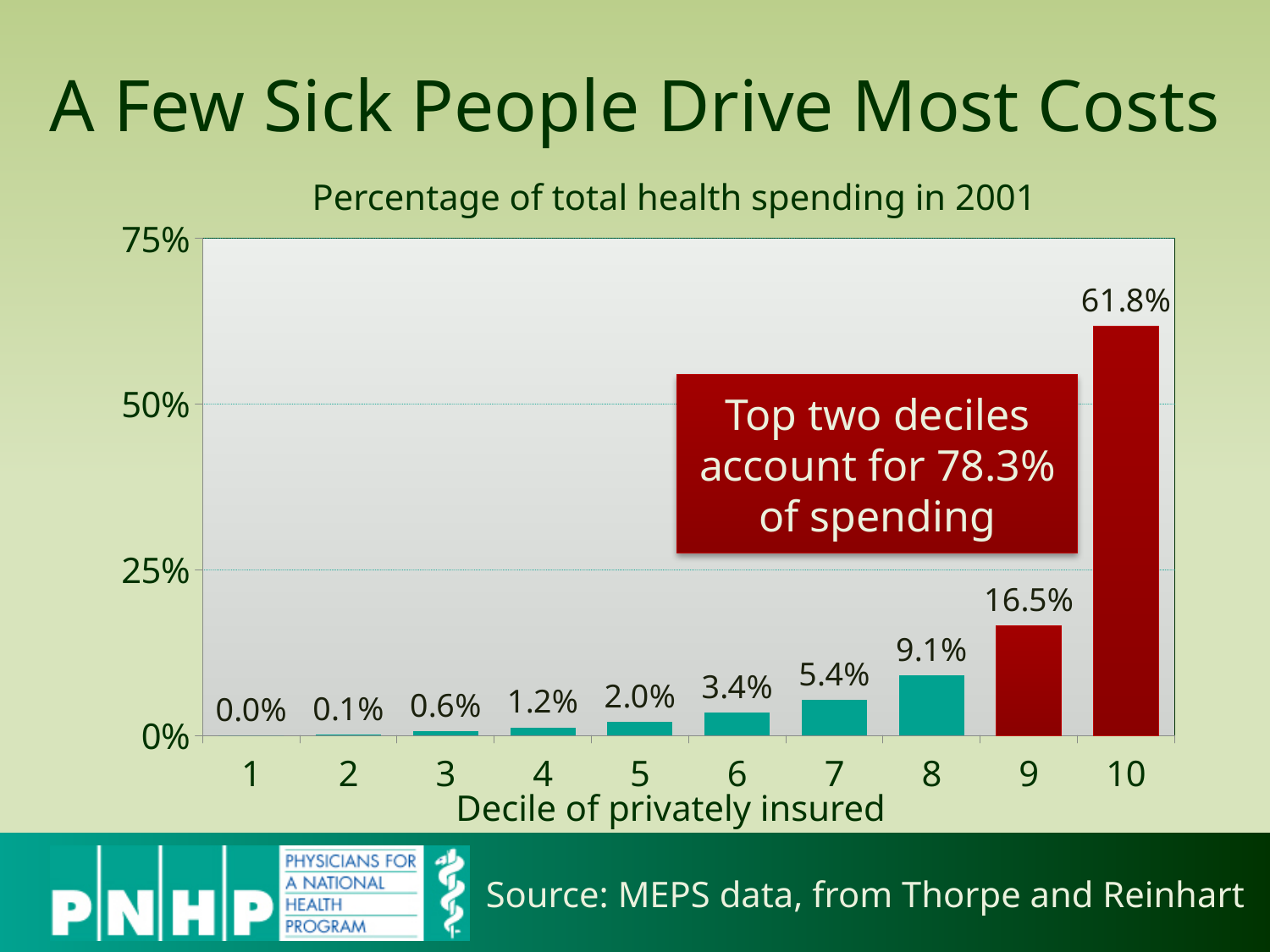
What kind of chart is shown on the slide? Bar chart What is the value shown for decile 9? 16.5% What is the combined value of deciles 9 and 10? 78.3% Is the value for decile 10 greater or less than 50%? greater Which decile has the lowest percentage of total health spending? 1 Which has a larger value, decile 6 or decile 8? Decile 8 Which decile has the highest percentage of total health spending? 10 What is the difference between the values for decile 10 and decile 9? 45.3% What percentage of total health spending is attributed to decile 7? 5.4% Do the values rise or fall as the decile number increases from 1 to 10? Rise What percentage of total health spending does decile 10 account for? 61.8% How many deciles are shown on the x axis? 10